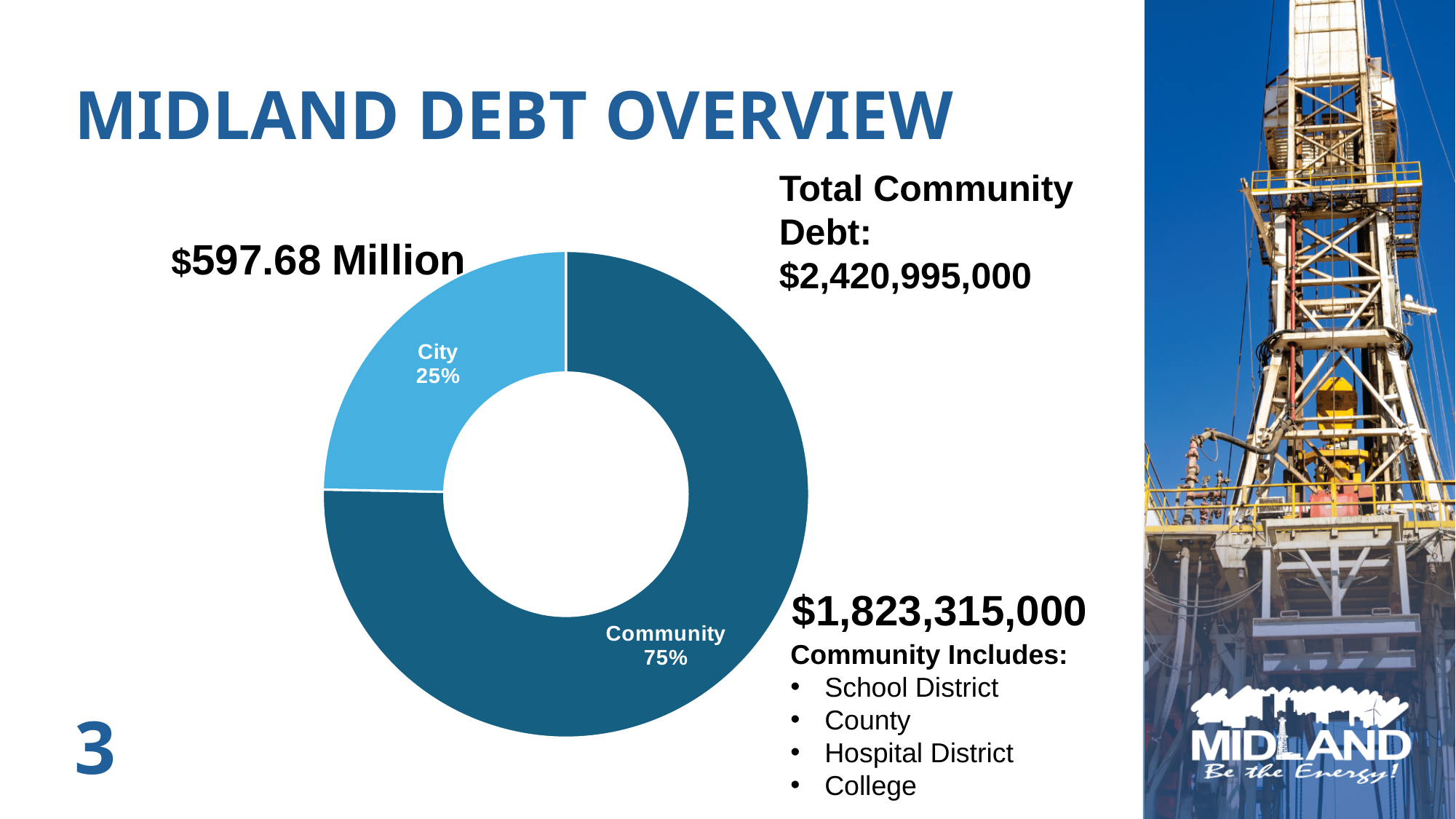
What dollar amount is shown next to the City slice? $597.68 Million What share of the pie does the Community slice represent? 75% Which slice of the pie is the largest? Community What share of the pie does the City slice represent? 25% Which is larger, the City share or the Community share? Community What is the difference in percentage points between the Community share and the City share? 50 percentage points What is the Total Community Debt stated on the slide? $2,420,995,000 What dollar amount is shown next to the Community slice? $1,823,315,000 Which slice of the pie is the smallest? City What is the title of the slide containing the chart? MIDLAND DEBT OVERVIEW What kind of chart is shown on the slide? Pie chart (doughnut) How many slices does the pie chart have? 2